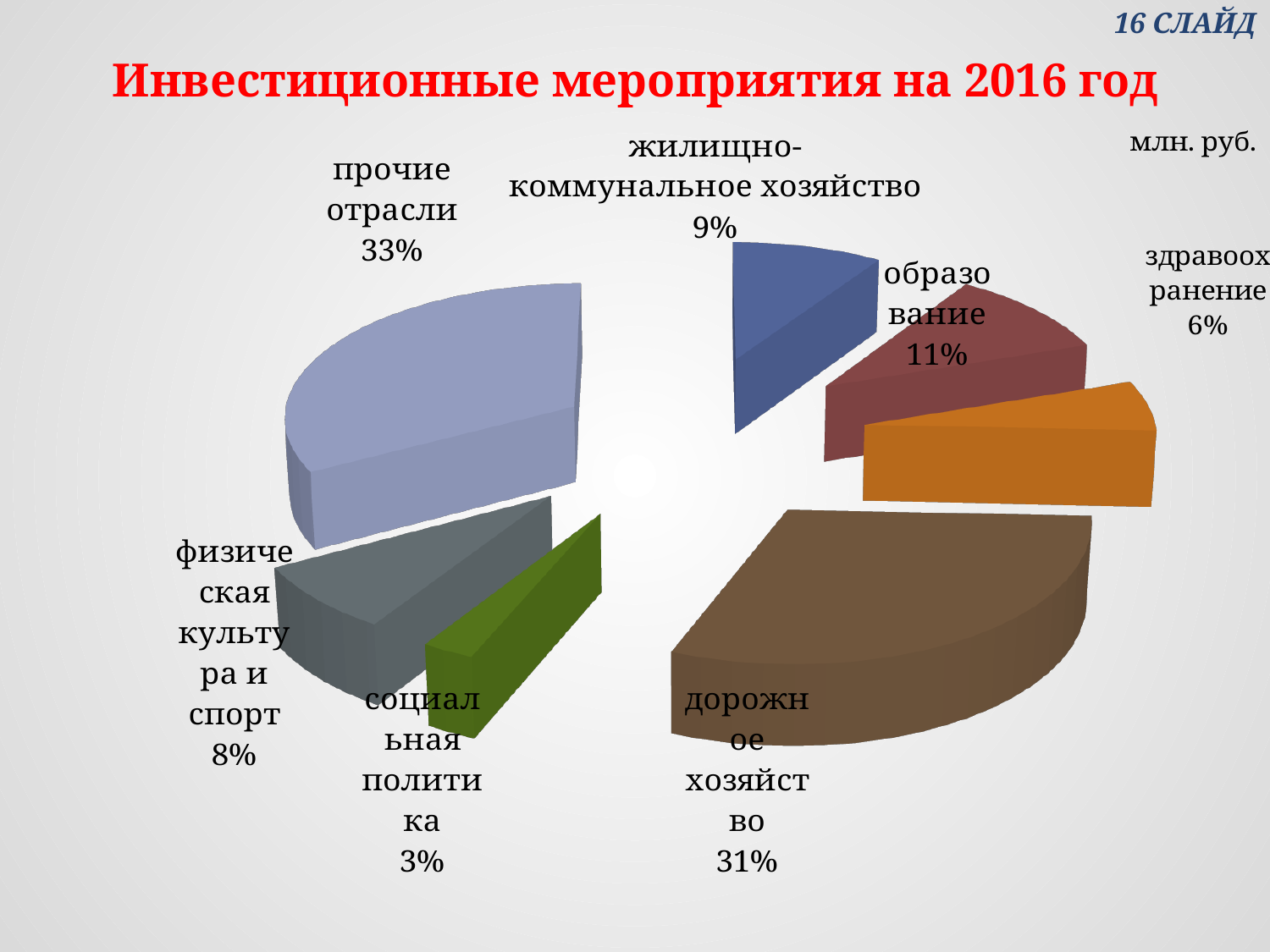
What share of the pie does "прочие отрасли" have? 33% Which category has the smallest slice of the pie? социальная политика What kind of chart is shown on the slide? pie chart Which is larger: the share for "образование" or the share for "физическая культура и спорт"? образование What is the difference between the shares of "прочие отрасли" and "дорожное хозяйство"? 2% What share of the pie does "дорожное хозяйство" have? 31% How many slices does the pie chart have? 7 What is the value shown for "здравоохранение"? 6% What is the title of the chart on the slide? Инвестиционные мероприятия на 2016 год Which category has the largest slice of the pie? прочие отрасли What is the value shown for "образование"? 11% What is the value shown for "жилищно-коммунальное хозяйство"? 9%